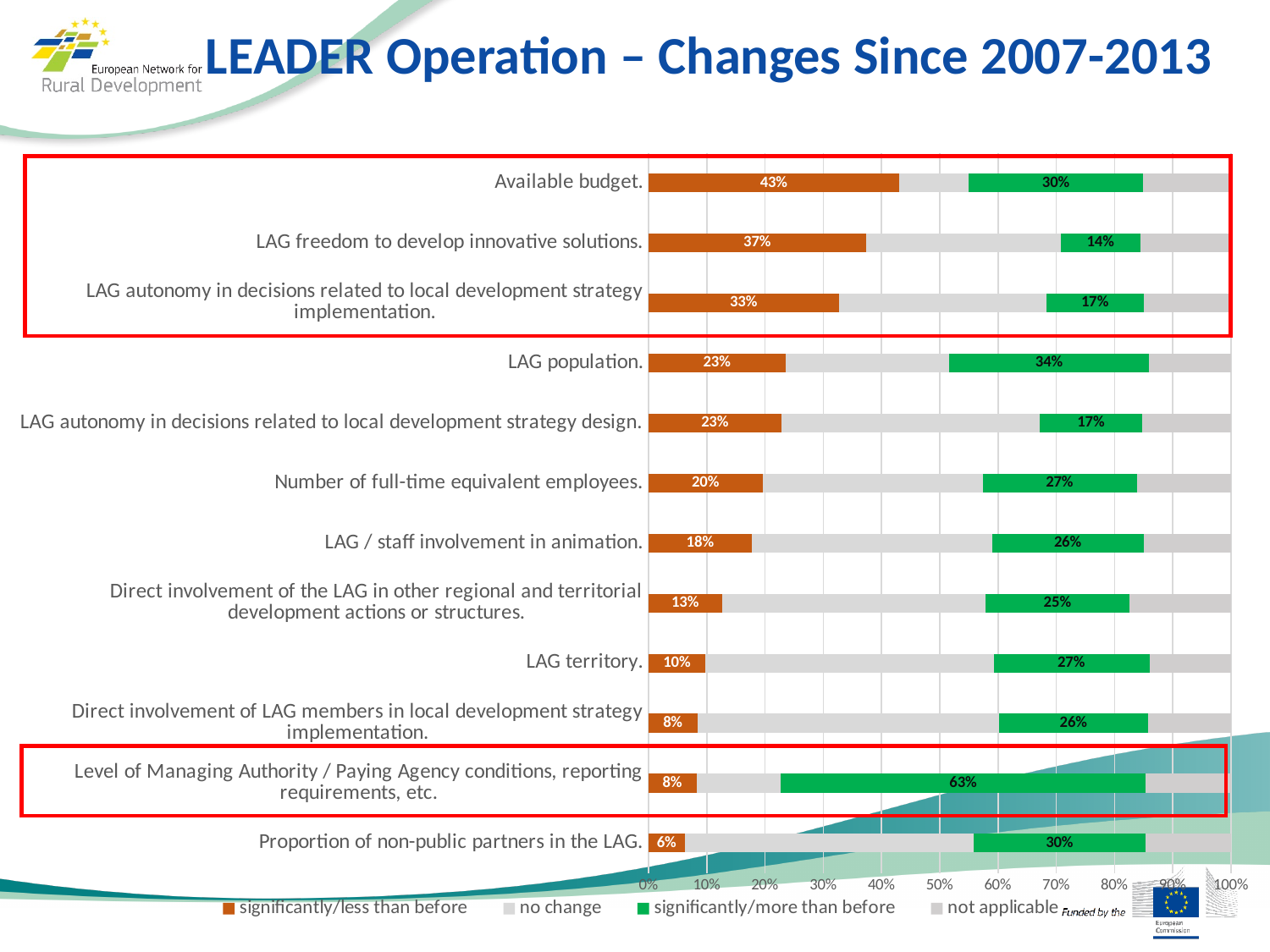
What kind of chart is shown on the slide? Stacked bar chart What is the 'significantly/more than before' value for LAG population? 34% What is the difference between the 'significantly/less than before' values for Available budget and LAG territory? 33% For LAG population, which is larger: 'significantly/less than before' or 'significantly/more than before'? significantly/more than before Which category has the highest 'significantly/less than before' value? Available budget. What percentage of respondents reported 'significantly/more than before' for Level of Managing Authority / Paying Agency conditions, reporting requirements, etc.? 63% Which category has the highest 'significantly/more than before' value? Level of Managing Authority / Paying Agency conditions, reporting requirements, etc. Which category has the lowest 'significantly/less than before' value? Proportion of non-public partners in the LAG. How many categories are shown in the chart? 12 How many series does the legend list? 4 What percentage of respondents reported 'significantly/less than before' for Available budget? 43% Which category has the lowest 'significantly/more than before' value? LAG freedom to develop innovative solutions.